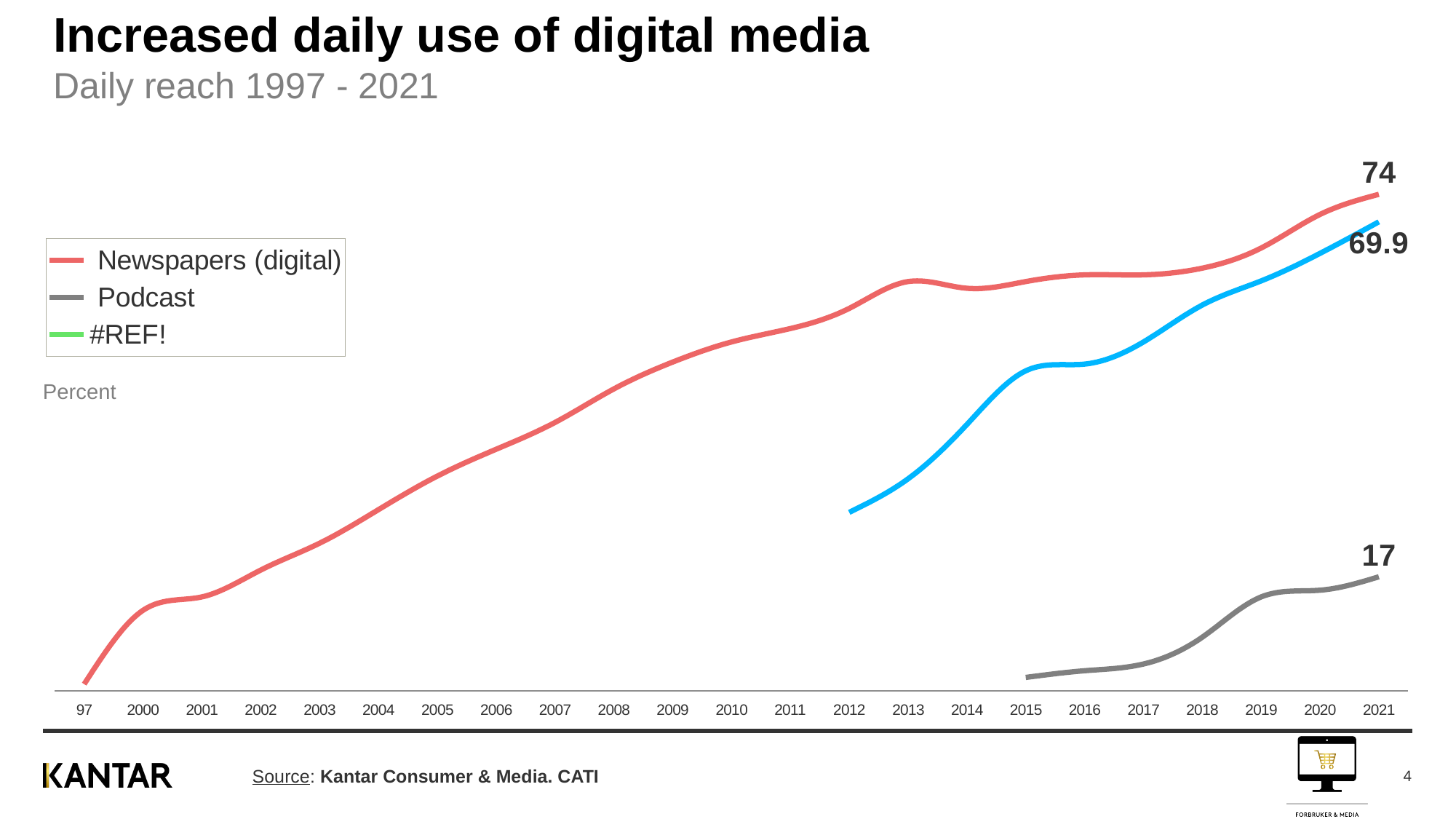
What is the value for Newspapers (digital) in 2021? 74 What unit is the chart measured in, according to the label on the slide? Percent What is the value for Podcast in 2021? 17 Which series has the higher value in 2021, Newspapers (digital) or Podcast? Newspapers (digital) What is the difference between the 2021 values for Newspapers (digital) and Podcast? 57 What value is labelled at the end of the blue line in 2021? 69.9 What kind of chart is shown on the slide? Line chart Which series has the highest value in 2021? Newspapers (digital) How many year labels are shown on the x axis? 23 Which series has the lowest value in 2021? Podcast Does the Newspapers (digital) line generally rise or fall from 97 to 2021? Rise How many series does the legend list? 3